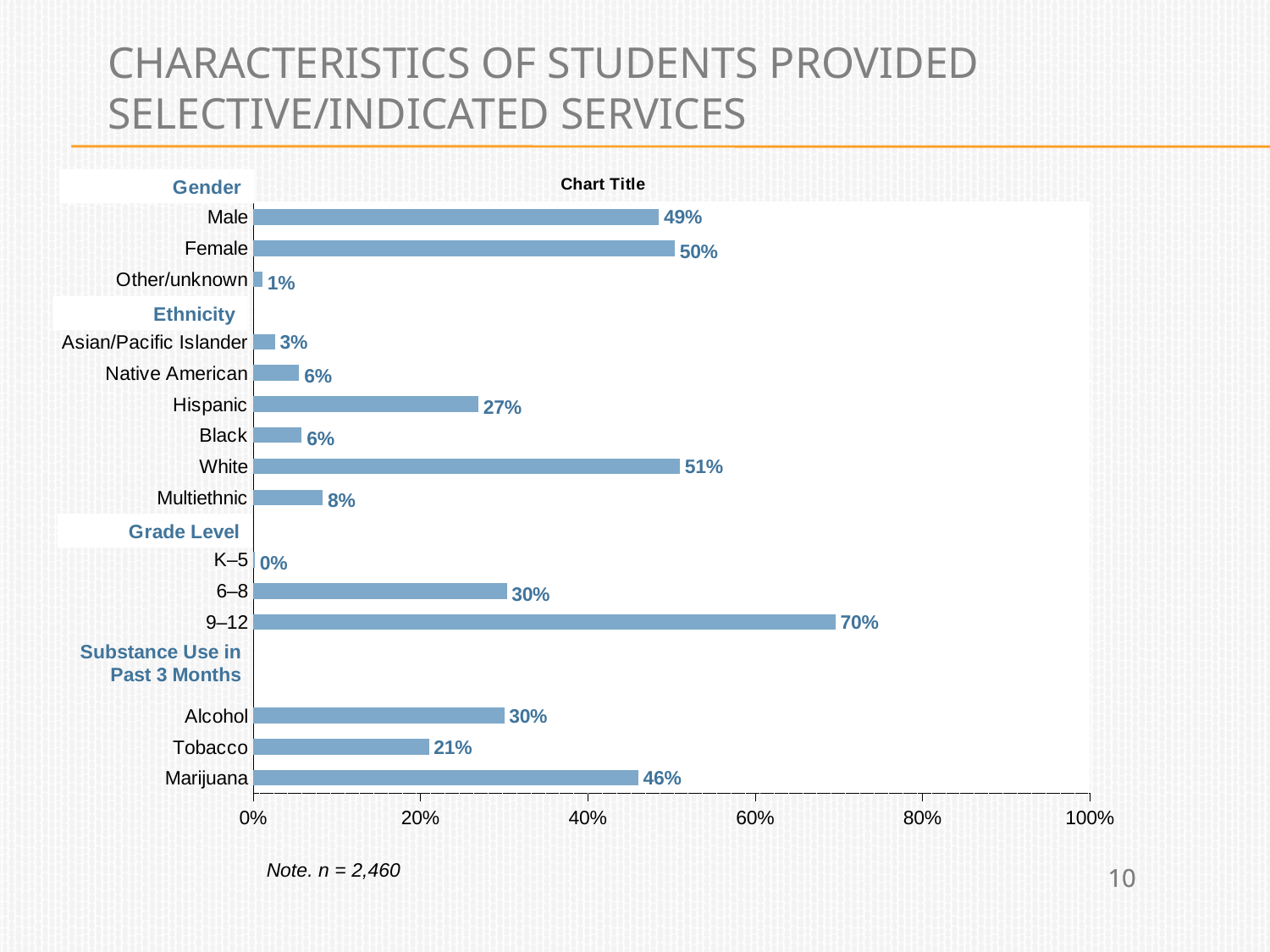
How many substance use categories are shown in the chart? 3 What percentage of students reported marijuana use in the past 3 months? 46% Which is larger, the value for Hispanic or the value for Multiethnic? Hispanic What percentage of students provided selective/indicated services were Hispanic? 27% What kind of chart is shown on the slide? Bar chart What is the difference between the Female and Male percentages? 1% What is the difference between the Alcohol and Tobacco percentages? 9% What is the sample size given in the note below the chart? n = 2,460 Which ethnicity category has the highest value? White What is the value shown for the 9–12 grade level? 70% Which grade level category has the lowest value? K–5 Is the value for 9–12 greater or less than 60%? greater